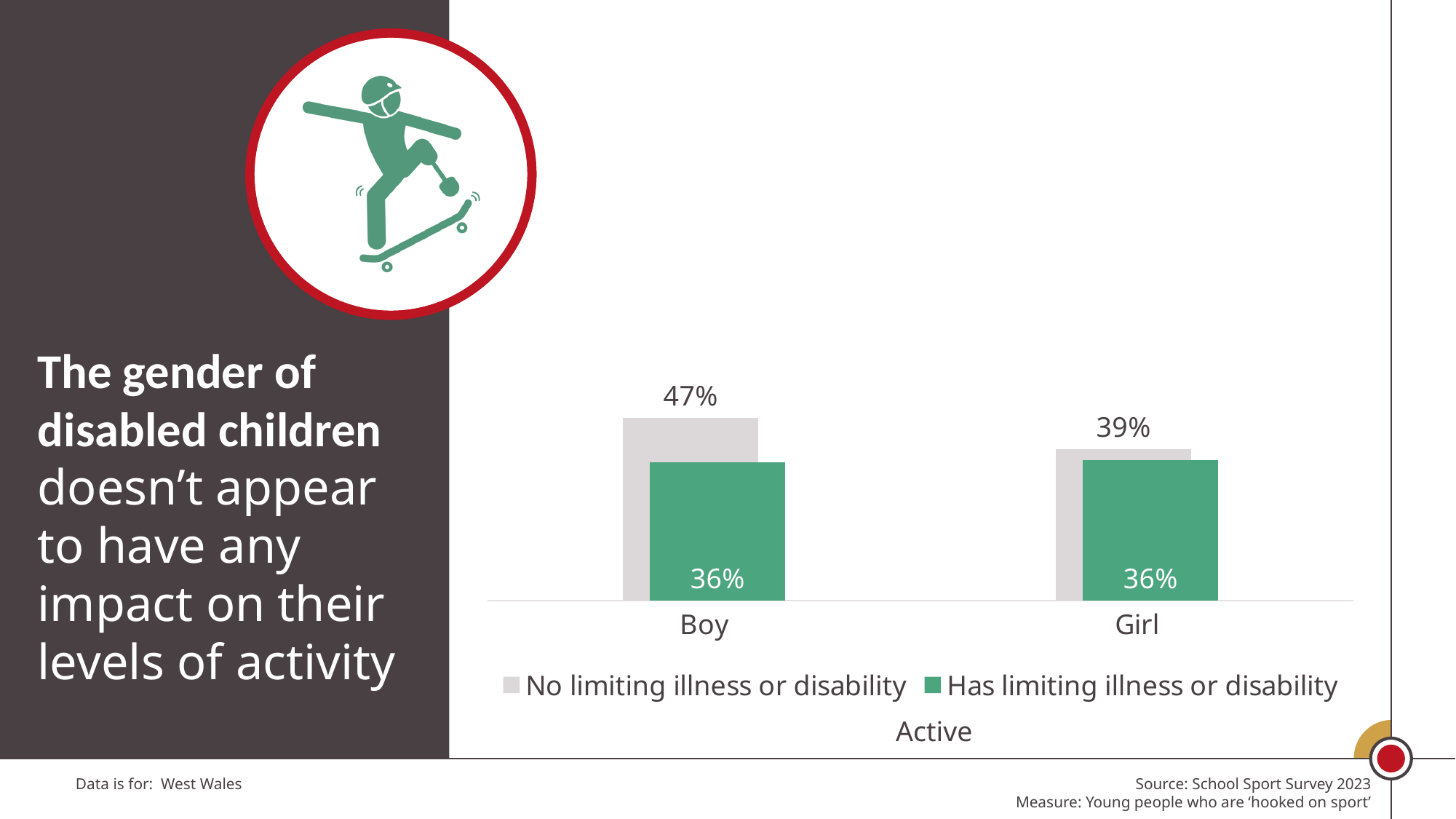
For Girl, which is larger: 'No limiting illness or disability' or 'Has limiting illness or disability'? No limiting illness or disability Which category has the highest value in the 'No limiting illness or disability' series? Boy What is the difference between the 'No limiting illness or disability' values for Boy and Girl? 8% What is the value for Boy in the 'Has limiting illness or disability' series? 36% What is the value for Girl in the 'Has limiting illness or disability' series? 36% For Boy, what is the difference between the 'No limiting illness or disability' and 'Has limiting illness or disability' values? 11% What is the value for Girl in the 'No limiting illness or disability' series? 39% What kind of chart is shown on the slide? Bar chart How many categories are shown on the x axis? 2 How many series does the legend list? 2 What colour are the bars for the 'Has limiting illness or disability' series? Green What is the value for Boy in the 'No limiting illness or disability' series? 47%